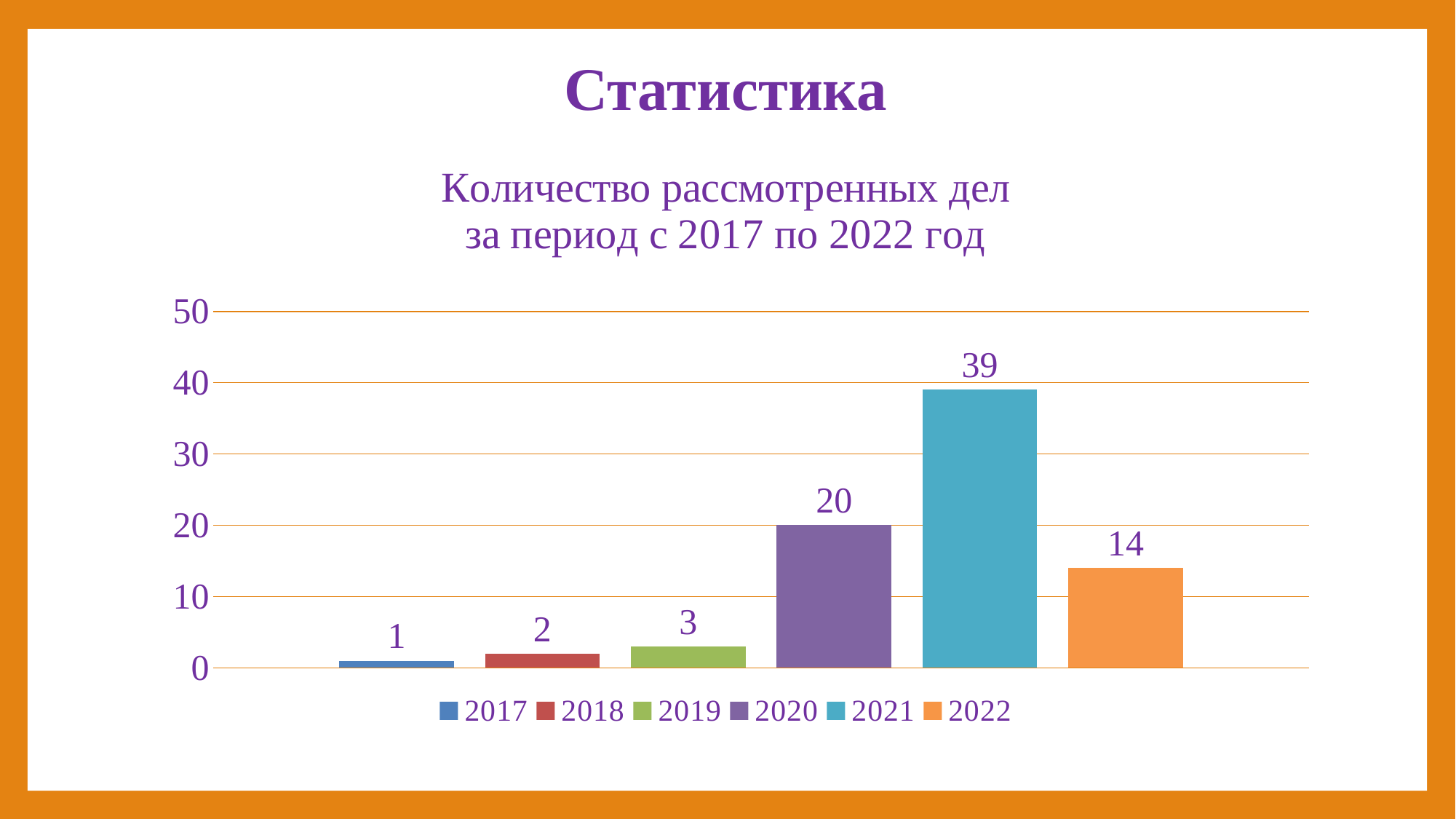
What is the difference between the values for 2022 and 2018? 12 Which year has the highest value? 2021 What is the value for 2019? 3 Is the value for 2021 greater or less than 30? greater What is the difference between the values for 2021 and 2020? 19 What is the title of the chart? Количество рассмотренных дел за период с 2017 по 2022 год Which is larger, the value for 2020 or the value for 2022? 2020 How many years are shown in the chart? 6 Which year has the lowest value? 2017 What is the value for 2022? 14 What is the value for 2021? 39 What kind of chart is shown on the slide? bar chart